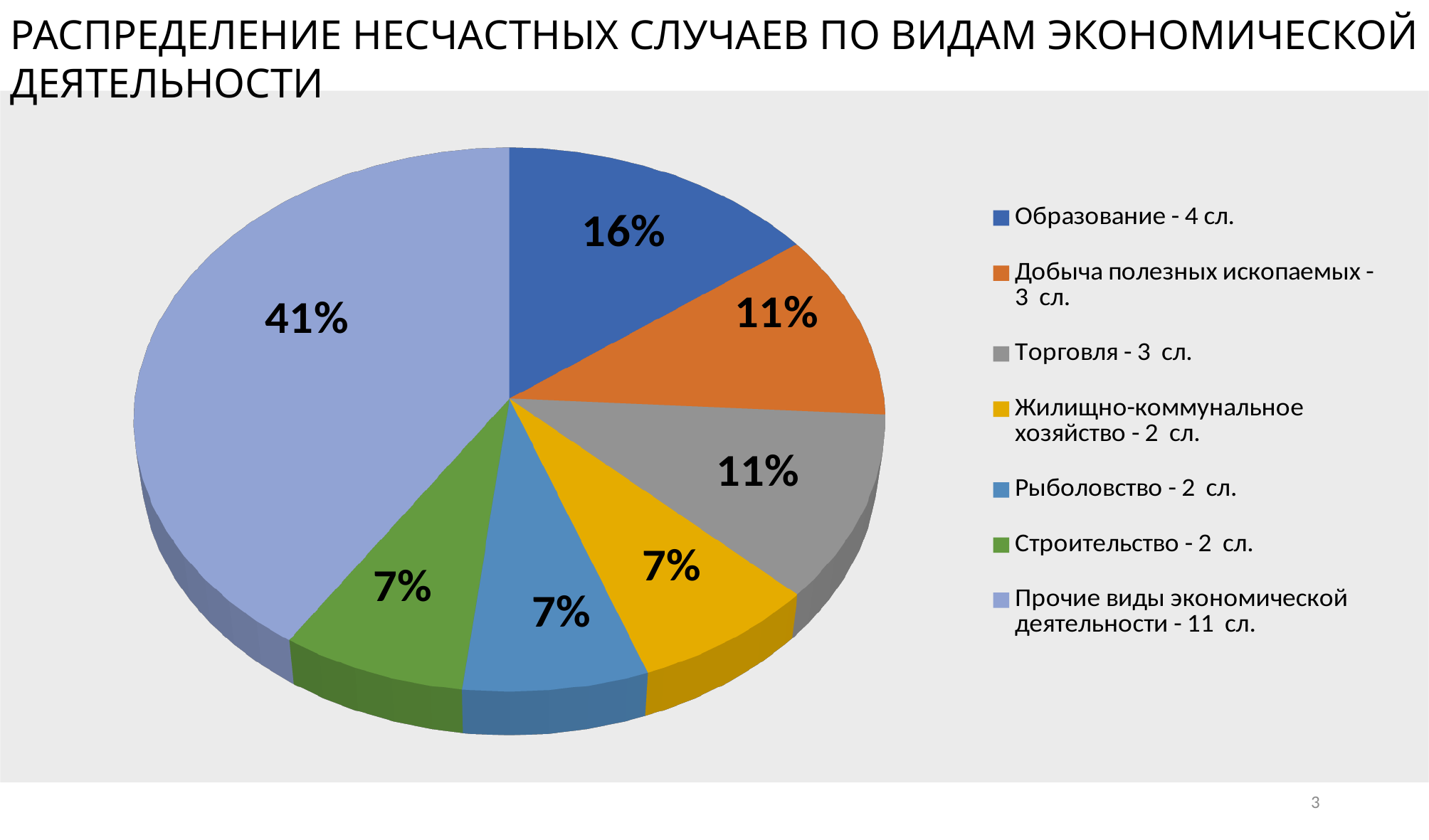
What colour is the slice for "Жилищно-коммунальное хозяйство - 2 сл."? yellow What kind of chart is shown on the slide? pie chart What share of the pie does "Торговля - 3 сл." take? 11% What is the smallest percentage shown on any slice of the pie? 7% How many entries does the legend list? 7 What share of the pie does "Строительство - 2 сл." take? 7% Which slice is larger: "Образование - 4 сл." or "Рыболовство - 2 сл."? Образование - 4 сл. What share of the pie does "Образование - 4 сл." take? 16% What is the difference in percentage points between the slice for "Прочие виды экономической деятельности - 11 сл." and the slice for "Образование - 4 сл."? 25% Which category has the largest slice of the pie? Прочие виды экономической деятельности - 11 сл. How many slices does the pie chart have? 7